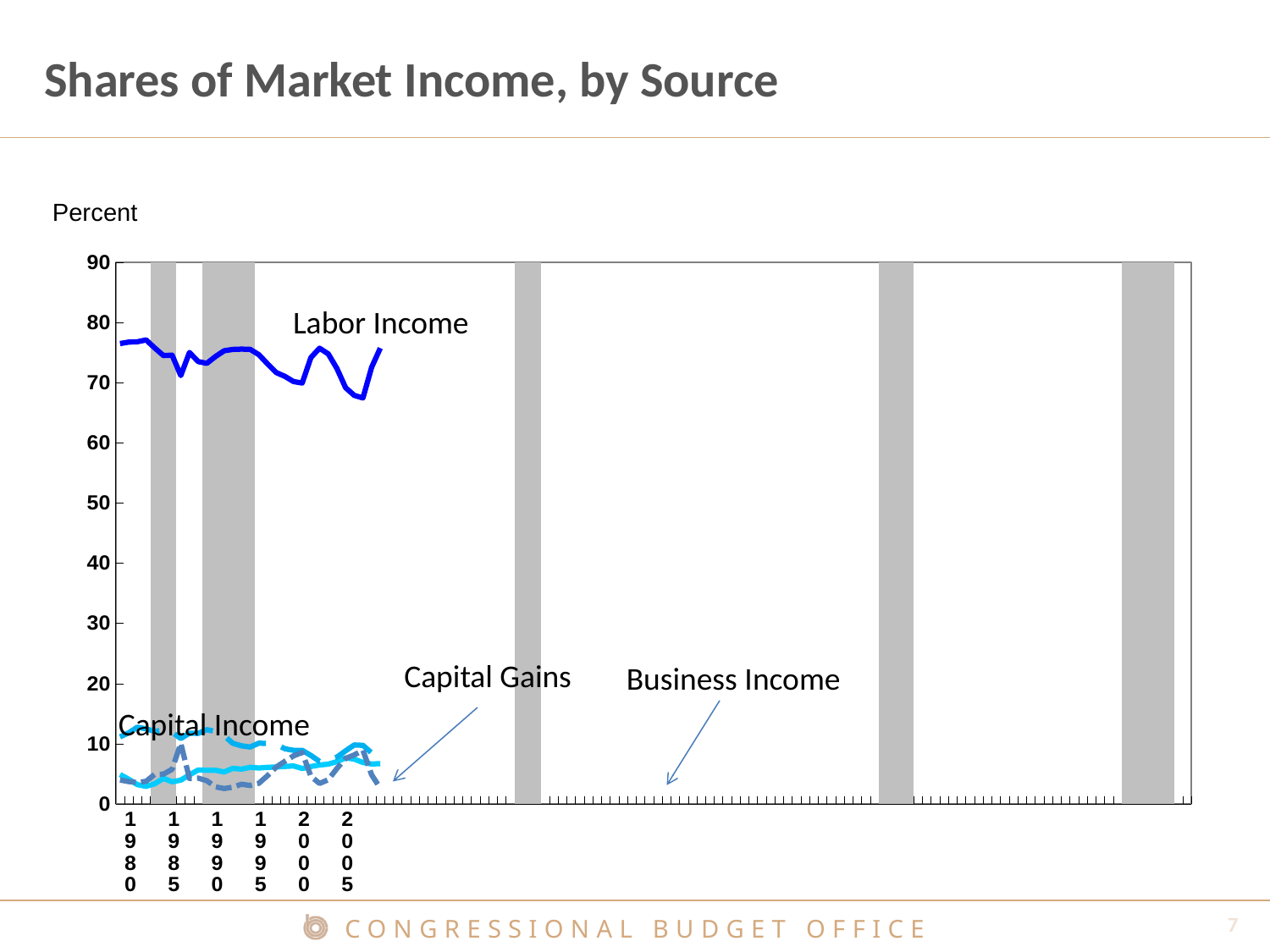
Which series has the highest values throughout the chart? Labor Income What unit is shown on the y axis of the chart? Percent Is the value for Labor Income in 1980 greater or less than 70? greater What is the title of the chart? Shares of Market Income, by Source Is the value for Labor Income in 1990 greater or less than 60? greater Which is larger in 1985, Labor Income or Capital Income? Labor Income Is the value for Capital Income in 1990 greater or less than 20? less What kind of chart is shown on the slide? line chart How many income sources are labeled as series on the chart? 4 How many year labels are shown on the x axis? 6